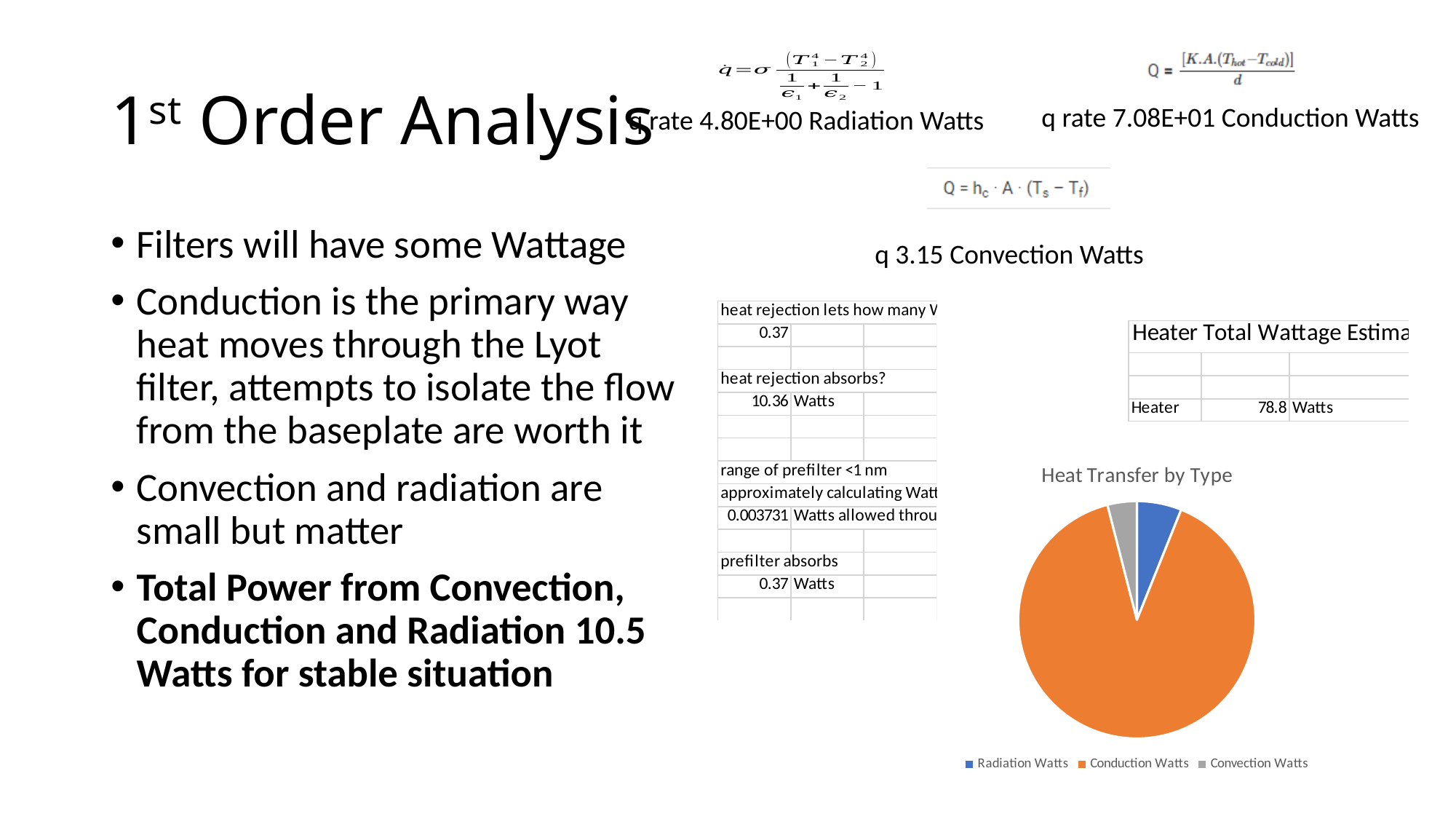
In the "Heat Transfer by Type" pie chart, which is larger: Radiation Watts or Convection Watts? Radiation Watts What kind of chart is the "Heat Transfer by Type" chart? pie chart What colour is the Conduction Watts slice in the "Heat Transfer by Type" pie chart? orange Which category has the smallest slice in the "Heat Transfer by Type" pie chart? Convection Watts What is the title of the pie chart on the slide? Heat Transfer by Type Which category has the largest slice in the "Heat Transfer by Type" pie chart? Conduction Watts In the "Heat Transfer by Type" pie chart, which is larger: Conduction Watts or Radiation Watts? Conduction Watts How many entries does the legend of the "Heat Transfer by Type" chart list? 3 How many slices does the "Heat Transfer by Type" pie chart have? 3